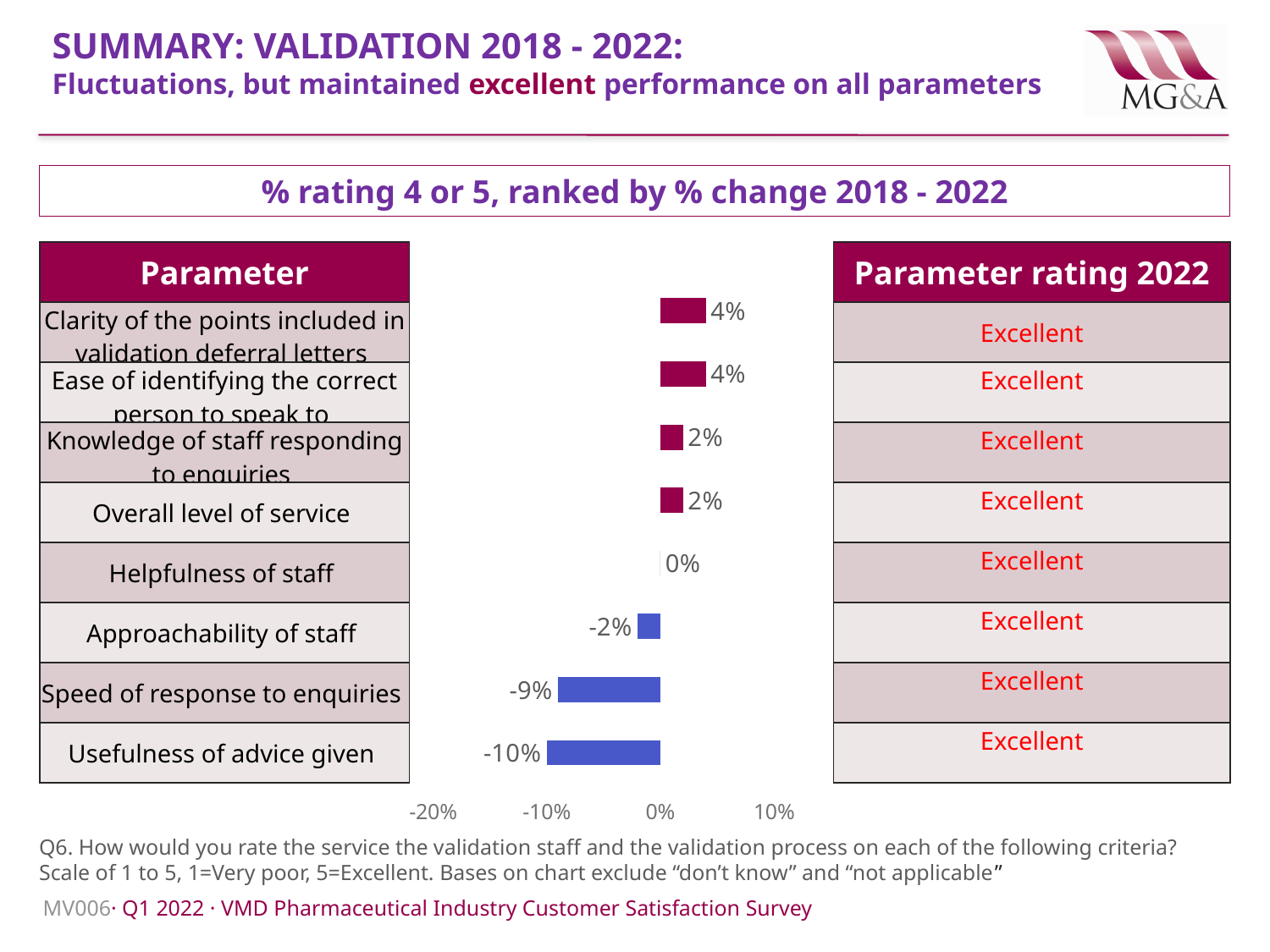
How many parameters show a negative % change 2018 - 2022? 3 What is the % change 2018 - 2022 for Helpfulness of staff? 0% How many parameters are plotted in the chart? 8 What kind of chart is shown on the slide? Bar chart Which has a larger % change 2018 - 2022: Knowledge of staff responding to enquiries or Speed of response to enquiries? Knowledge of staff responding to enquiries What is the % change 2018 - 2022 for Overall level of service? 2% Is the % change for Usefulness of advice given greater or less than -20%? greater What is the % change 2018 - 2022 for Approachability of staff? -2% What is the title of the chart? % rating 4 or 5, ranked by % change 2018 - 2022 What is the % change 2018 - 2022 for Speed of response to enquiries? -9% Which parameter has the lowest % change 2018 - 2022? Usefulness of advice given What is the difference between the % change for Ease of identifying the correct person to speak to and the % change for Usefulness of advice given? 14 percentage points